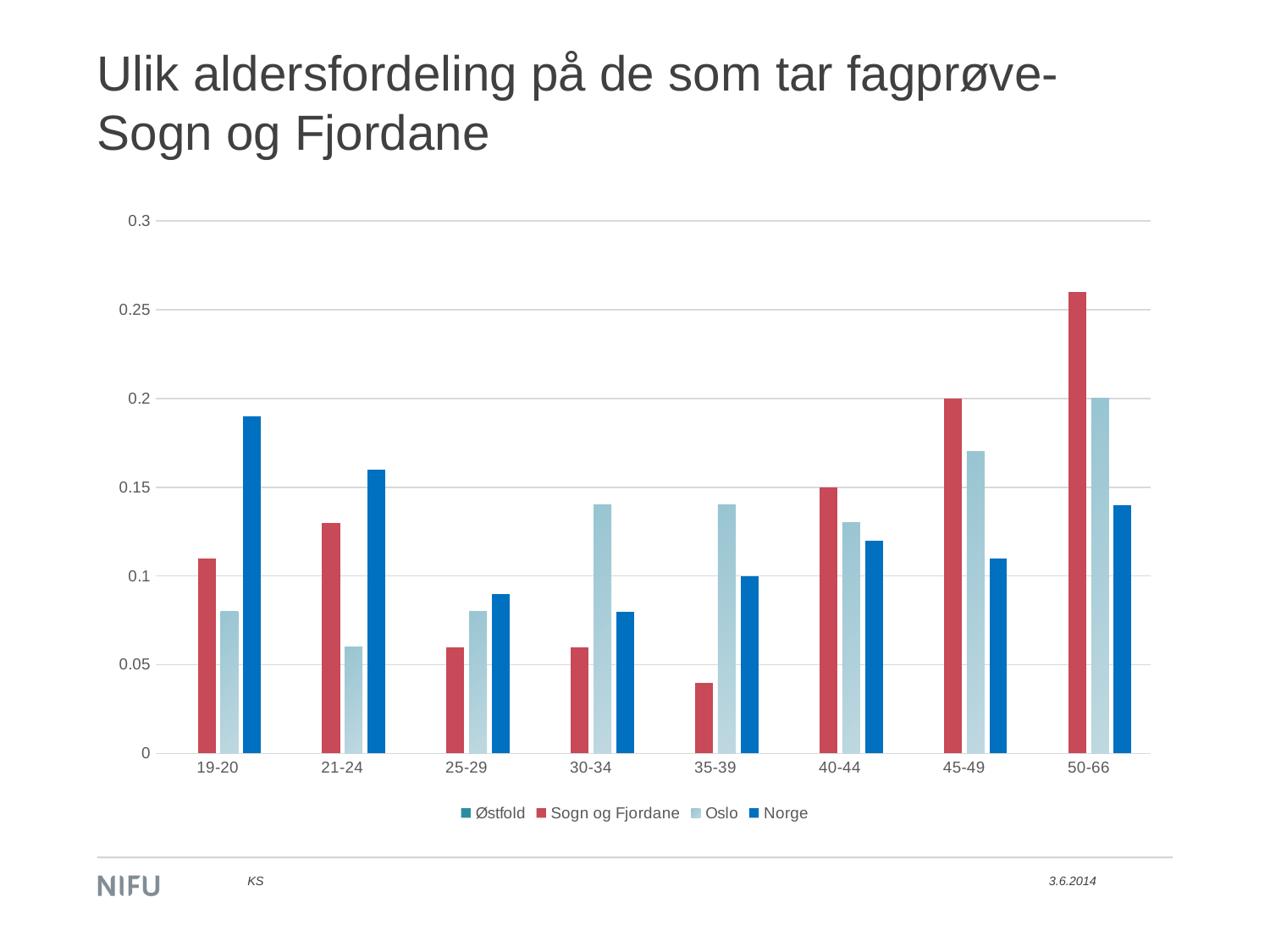
Is the value for Norge in the 19-20 age group greater or less than 0.15? greater Which age group has the lowest value for Sogn og Fjordane? 35-39 How many age-group categories are shown on the x axis? 8 Which age group has the highest value for Sogn og Fjordane? 50-66 In the 45-49 age group, which is larger: Sogn og Fjordane or Norge? Sogn og Fjordane In the 19-20 age group, which is larger: Norge or Sogn og Fjordane? Norge Which age group has the highest value for Norge? 19-20 Is the value for Sogn og Fjordane in the 50-66 age group greater or less than 0.2? greater Is the value for Sogn og Fjordane in the 35-39 age group greater or less than 0.05? less Which age group has the lowest value for Oslo? 21-24 What kind of chart is shown on the slide? bar chart How many series does the legend list? 4